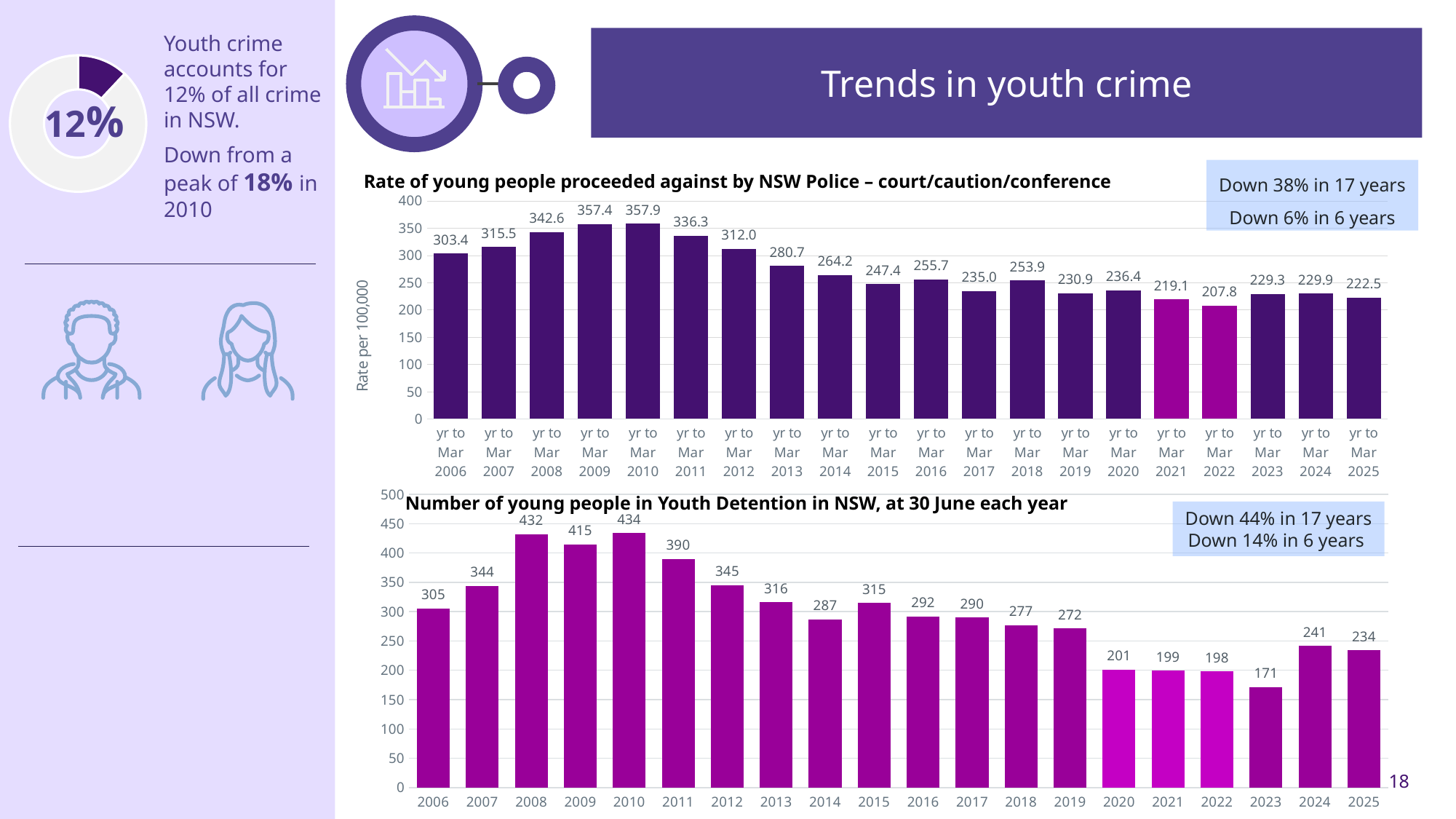
In the chart 'Number of young people in Youth Detention in NSW', which year has the highest number? 2010 In the chart 'Rate of young people proceeded against by NSW Police', how many bars are plotted? 20 In the chart 'Rate of young people proceeded against by NSW Police', what is the value for yr to Mar 2010? 357.9 In the chart 'Number of young people in Youth Detention in NSW', what is the value for 2023? 171 In the chart 'Number of young people in Youth Detention in NSW', what is the difference between the values for 2024 and 2025? 7 In the chart 'Number of young people in Youth Detention in NSW', which year has the lowest number? 2023 What type of chart is 'Rate of young people proceeded against by NSW Police'? Bar chart In the chart 'Rate of young people proceeded against by NSW Police', what is the difference between the values for yr to Mar 2006 and yr to Mar 2025? 80.9 What is the y-axis label of the chart 'Rate of young people proceeded against by NSW Police'? Rate per 100,000 In the chart 'Rate of young people proceeded against by NSW Police', which year has the highest rate? yr to Mar 2010 In the chart 'Rate of young people proceeded against by NSW Police', which year has the lowest rate? yr to Mar 2022 In the chart 'Number of young people in Youth Detention in NSW', which is larger, the value for 2008 or the value for 2009? 2008